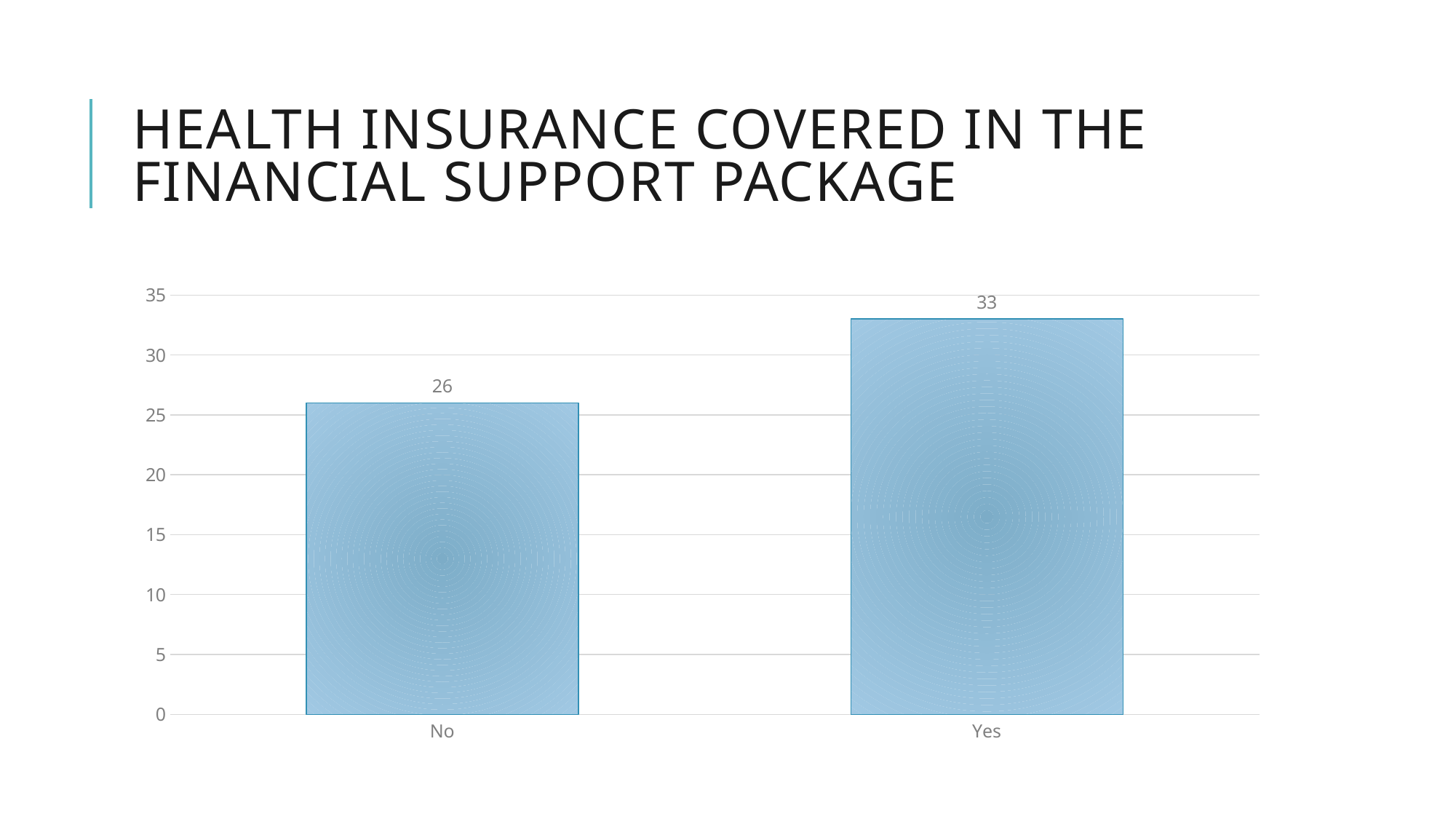
Which is larger, the value for "Yes" or the value for "No"? Yes Is the value for "Yes" greater or less than 30? greater Is the value for "No" greater or less than 30? less Which category has the highest value? Yes What is the difference between the values for "Yes" and "No"? 7 What is the total of the two bars combined? 59 What kind of chart is shown on the slide? bar chart What is the title of the slide? Health insurance covered in the financial support package What is the value for "Yes"? 33 Which category has the lowest value? No What is the value for "No"? 26 How many categories are shown on the x axis? 2